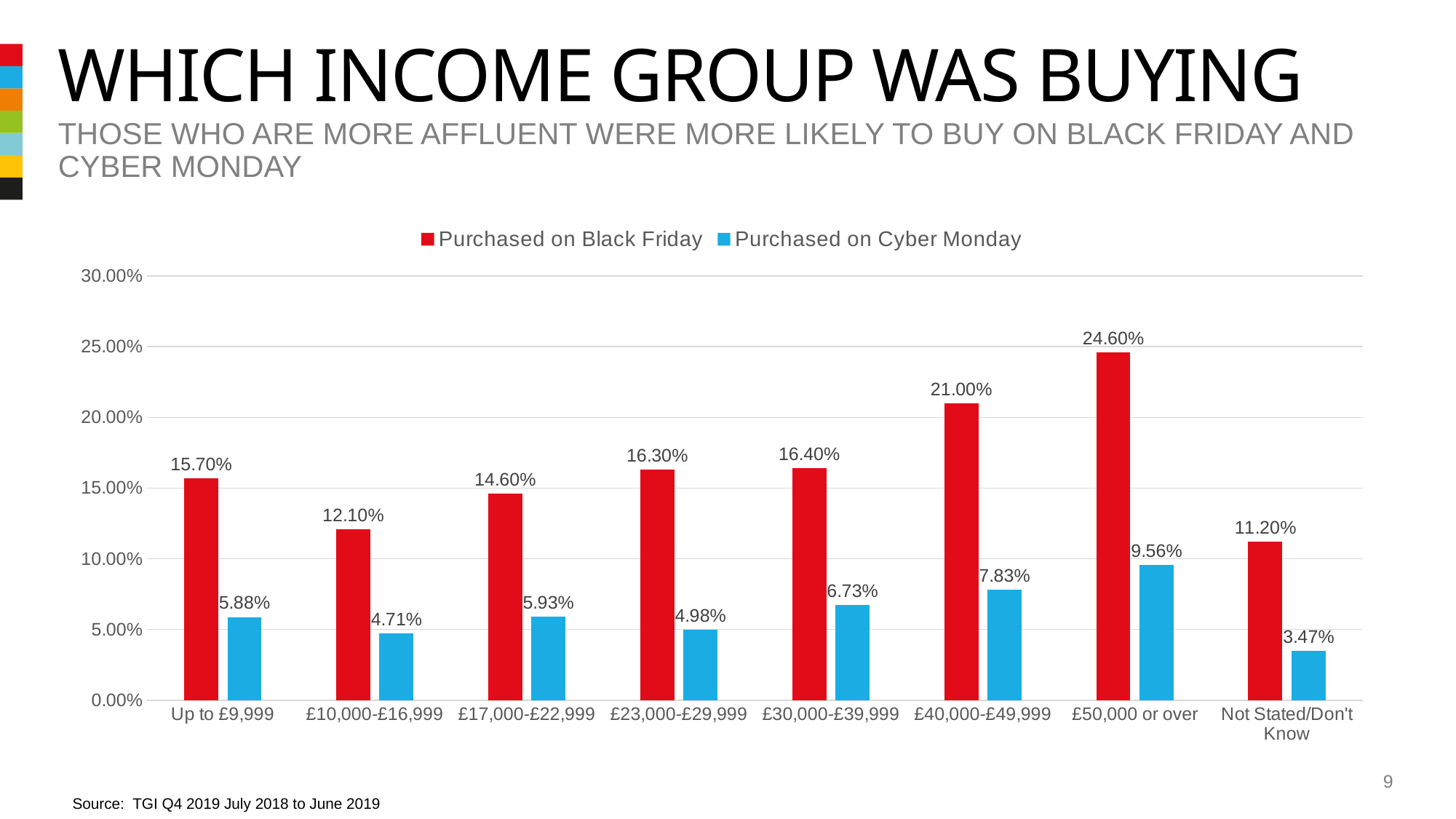
How many series does the legend list? 2 What kind of chart is shown on the slide? bar chart Which is larger: the Cyber Monday value for £30,000-£39,999 or for £23,000-£29,999? £30,000-£39,999 What percentage of the £50,000 or over income group purchased on Black Friday? 24.60% Is the Purchased on Black Friday value for £17,000-£22,999 greater or less than 15.00%? less What is the difference between the Black Friday and Cyber Monday values for the £40,000-£49,999 group? 13.17% Which income group has the highest Purchased on Black Friday value? £50,000 or over Which colour represents Purchased on Cyber Monday in the legend? blue What percentage of the £10,000-£16,999 income group purchased on Cyber Monday? 4.71% What is the Purchased on Black Friday value for the Not Stated/Don't Know group? 11.20% Which income group has the lowest Purchased on Cyber Monday value? Not Stated/Don't Know How many income group categories are shown on the x axis? 8